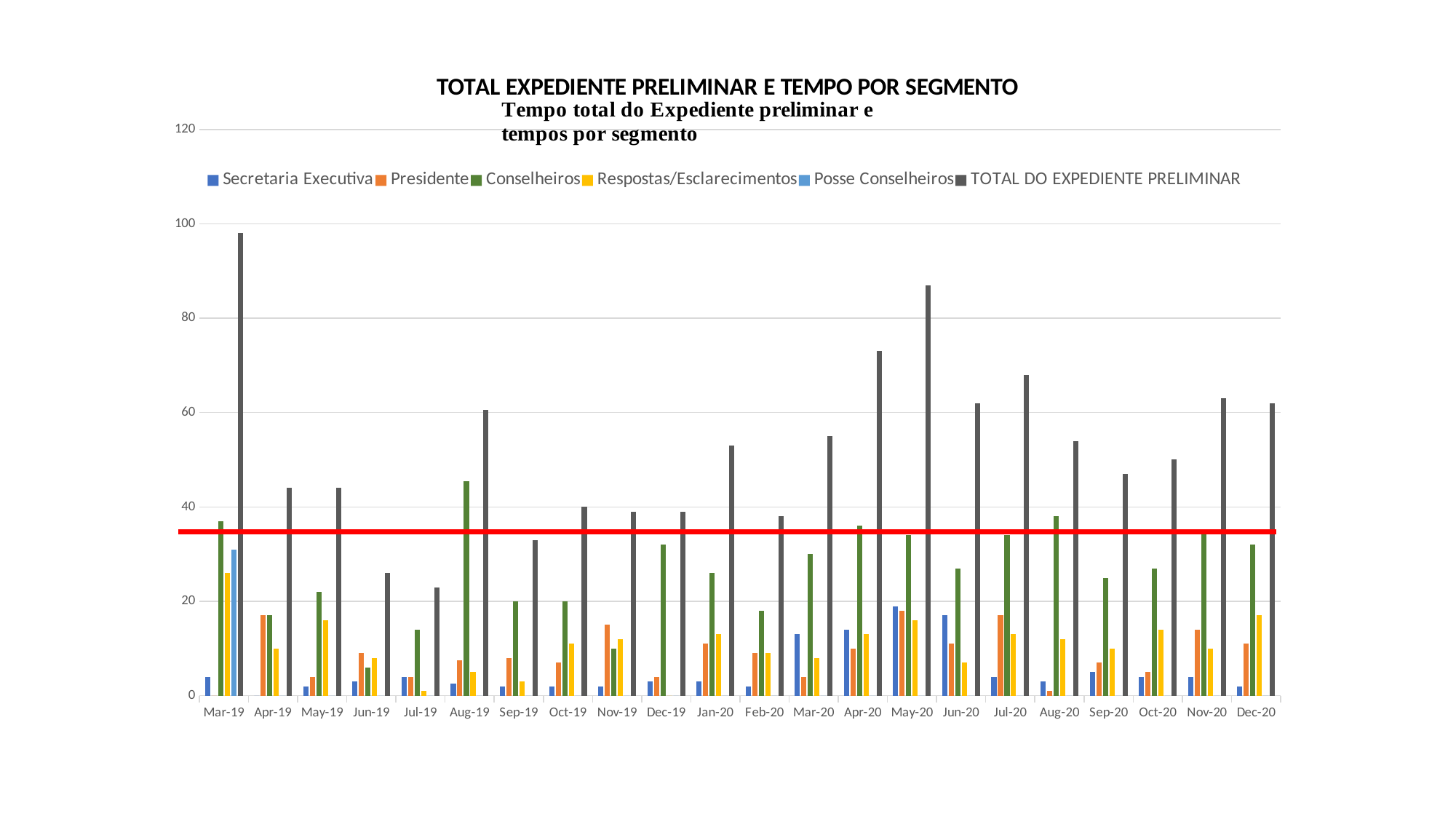
In which month does the Posse Conselheiros series have a visible bar? Mar-19 Is the Conselheiros value for Aug-19 greater or less than 40? greater What is the title printed at the top of the chart? TOTAL EXPEDIENTE PRELIMINAR E TEMPO POR SEGMENTO How many series does the legend list? 6 Which is larger, the TOTAL DO EXPEDIENTE PRELIMINAR value for Mar-19 or for May-20? Mar-19 Is the TOTAL DO EXPEDIENTE PRELIMINAR value for Jul-19 greater or less than 40? less How many months are shown along the x axis? 22 Which month has the highest value for TOTAL DO EXPEDIENTE PRELIMINAR? Mar-19 Is the TOTAL DO EXPEDIENTE PRELIMINAR value for Mar-19 greater or less than 80? greater What kind of chart is shown on the slide? bar chart Which is larger, the Conselheiros value for Aug-19 or for Jul-19? Aug-19